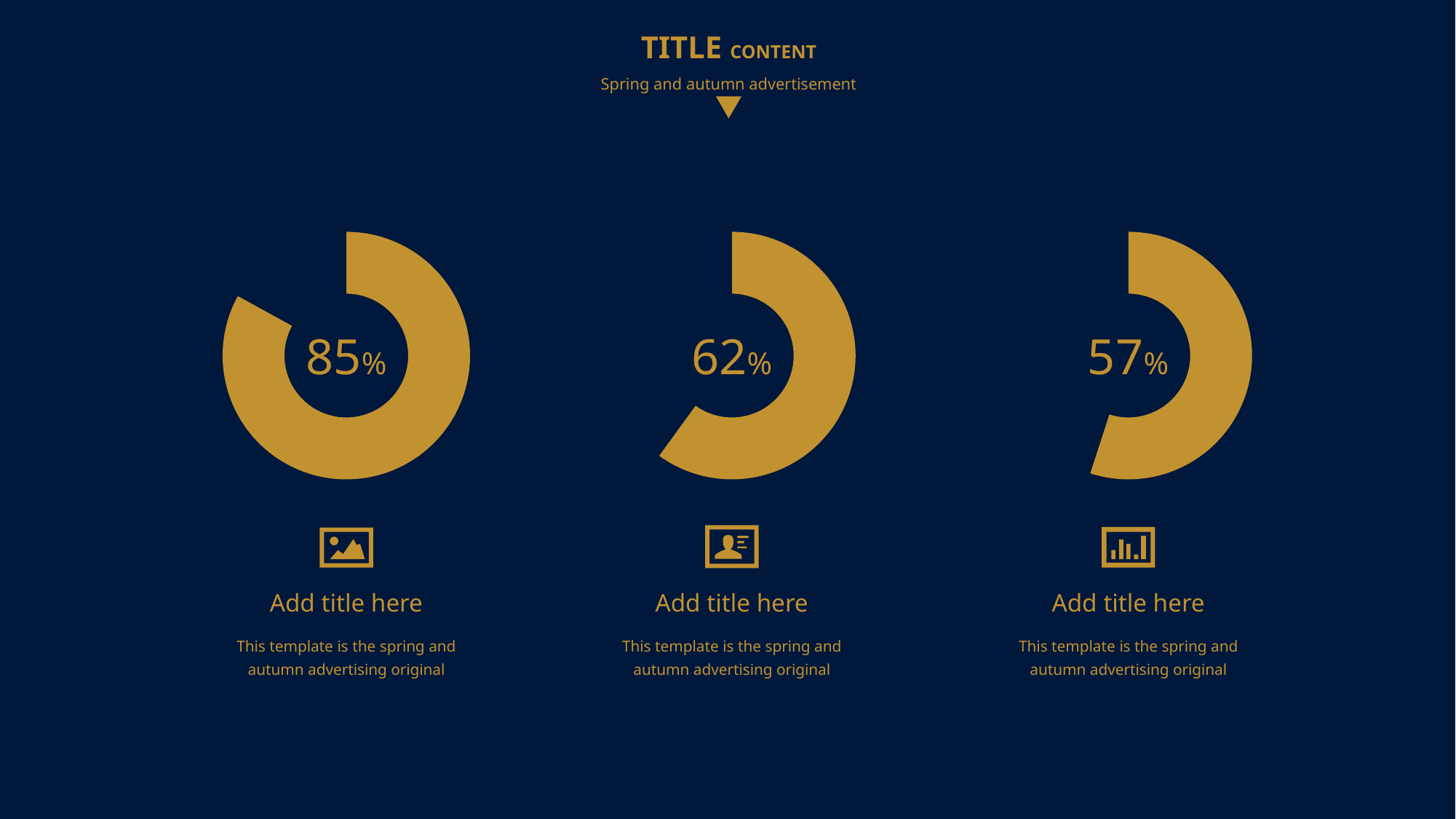
What is the difference between the percentage in the middle donut chart and the percentage in the right donut chart? 5% What value is shown in the right donut chart? 57% Which is larger, the percentage in the left donut chart or the percentage in the middle donut chart? left What value is shown in the middle donut chart? 62% Which of the three donut charts shows the highest percentage: left, middle or right? left What kind of chart is used to display the three percentages on the slide? donut chart Do the percentages in the donut charts increase or decrease from left to right across the slide? decrease How many donut charts are shown on the slide? 3 What colour are the filled rings of the donut charts? gold What is the difference between the percentage in the left donut chart and the percentage in the right donut chart? 28% What value is shown in the left donut chart? 85% Which of the three donut charts shows the lowest percentage: left, middle or right? right